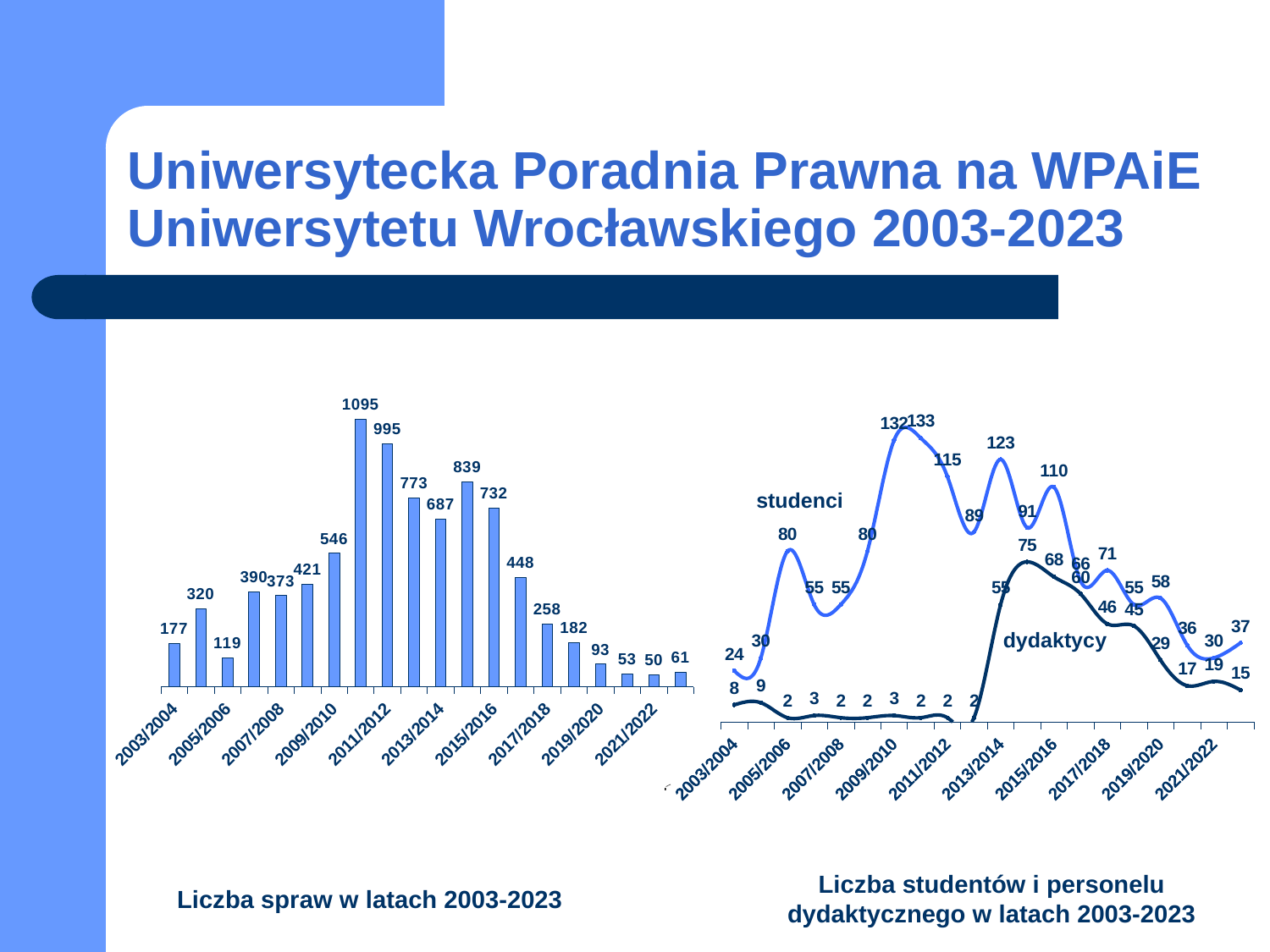
How many series are plotted in the chart "Liczba studentów i personelu dydaktycznego w latach 2003-2023"? 2 In the chart "Liczba studentów i personelu dydaktycznego w latach 2003-2023", what is the highest value of the studenci series? 133 What kind of chart is the chart titled "Liczba spraw w latach 2003-2023"? bar chart In the chart "Liczba spraw w latach 2003-2023", what is the highest value shown? 1095 In the chart "Liczba spraw w latach 2003-2023", how many bars are plotted? 20 In the chart "Liczba spraw w latach 2003-2023", what is the difference between the two tallest bars, 1095 and 995? 100 In the chart "Liczba spraw w latach 2003-2023", what is the lowest value shown? 50 In the chart "Liczba spraw w latach 2003-2023", what is the value for 2003/2004? 177 In the chart "Liczba studentów i personelu dydaktycznego w latach 2003-2023", what is the highest value of the dydaktycy series? 75 What kind of chart is the chart titled "Liczba studentów i personelu dydaktycznego w latach 2003-2023"? line chart In the chart "Liczba spraw w latach 2003-2023", which is larger, the bar labelled 839 or the bar labelled 773? 839 In the chart "Liczba studentów i personelu dydaktycznego w latach 2003-2023", what is the value of the studenci series for 2003/2004? 24